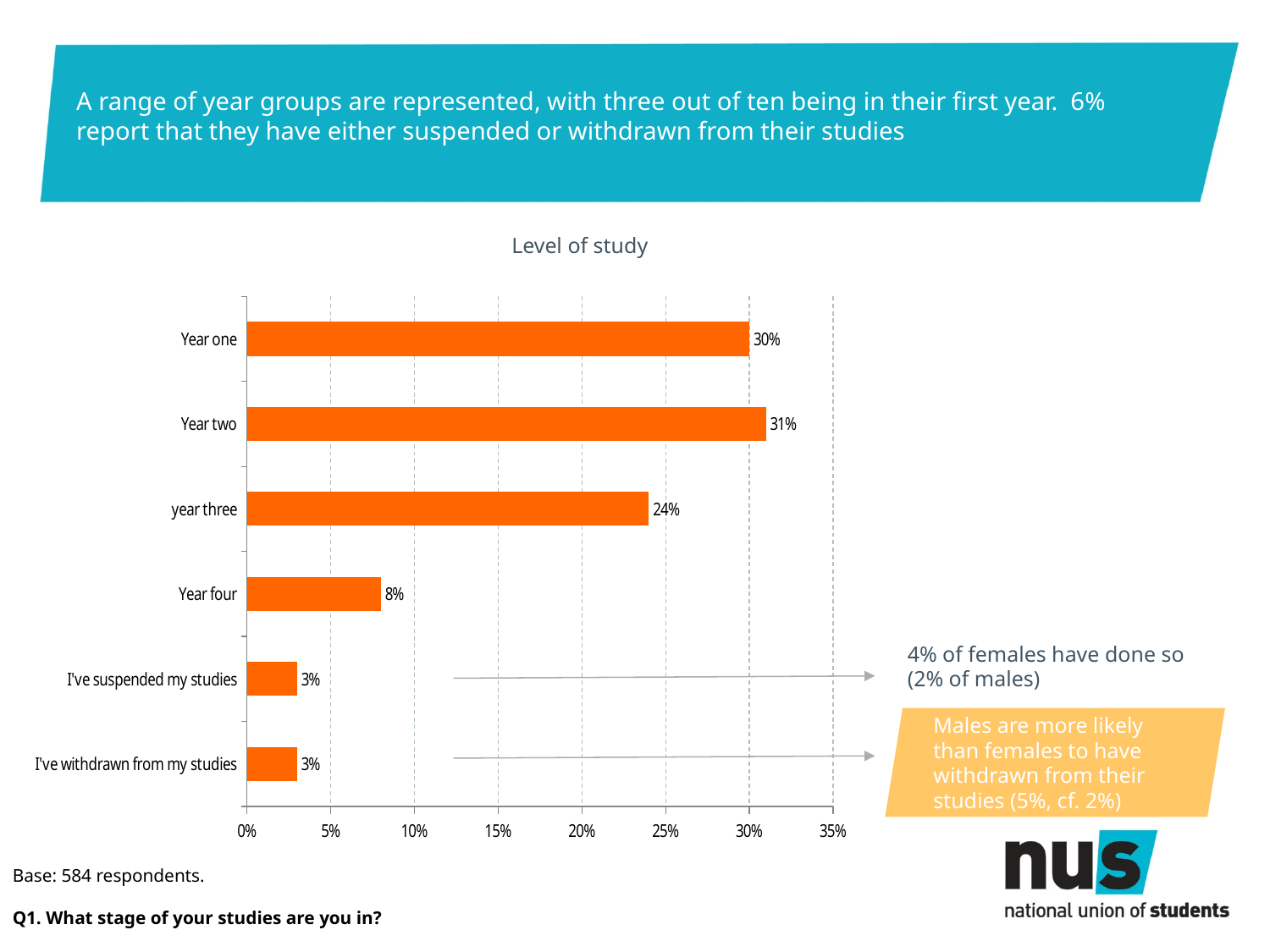
What is the difference between the values for Year two and year three? 7% What is the difference between the values for Year four and 'I've withdrawn from my studies'? 5% What is the value for Year four? 8% Which category has the highest value? Year two How many categories are shown on the chart? 6 What is the value for 'I've suspended my studies'? 3% Which is larger, the value for Year one or the value for Year four? Year one What is the value for Year two? 31% What is the value for year three? 24% What is the value for Year one? 30% What kind of chart is shown on the slide? Bar chart What is the title of the chart? Level of study